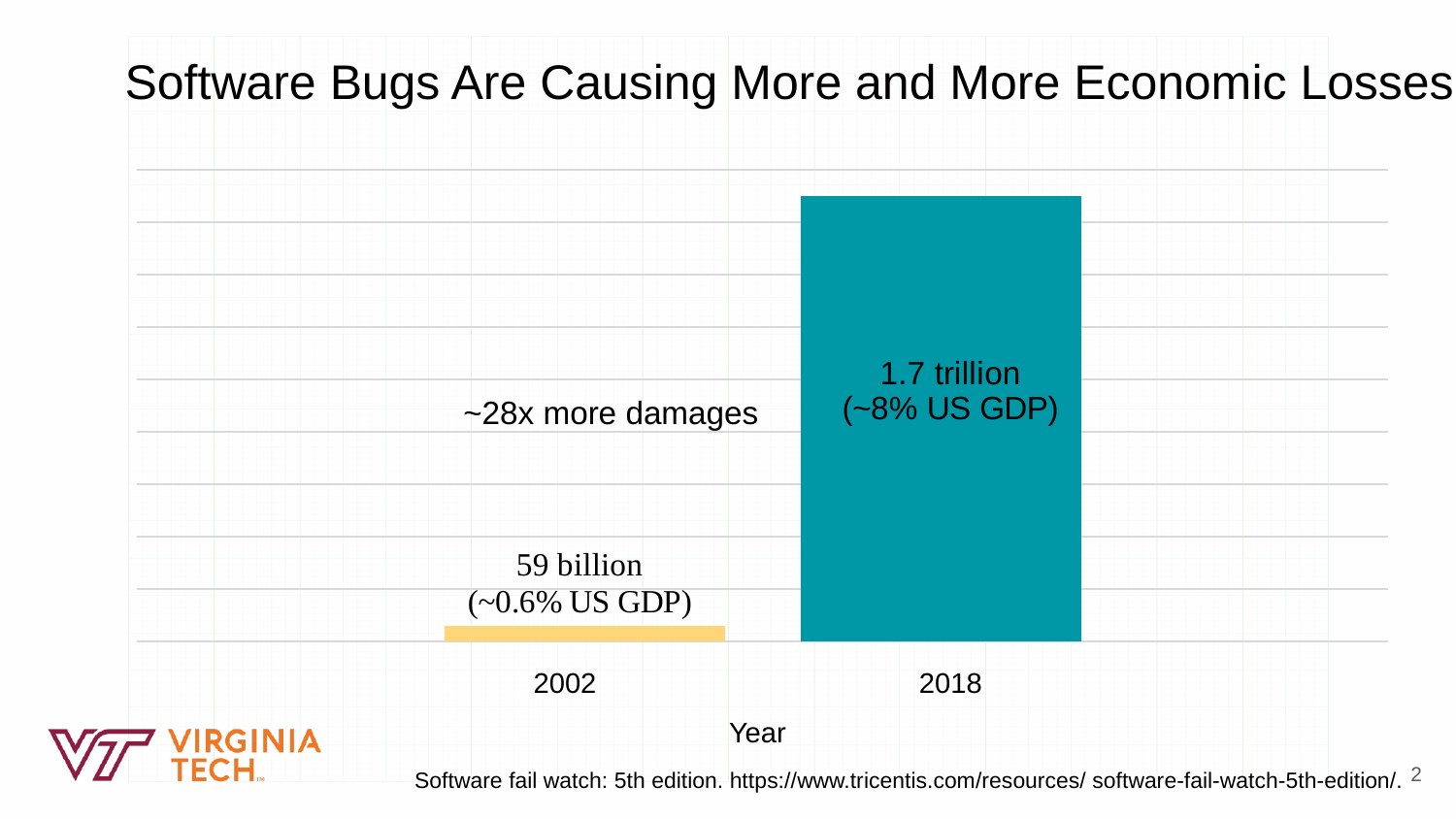
What share of US GDP does the slide give for the 2018 losses? ~8% US GDP Which is larger, the value for 2002 or the value for 2018? 2018 Which year has the highest bar? 2018 What is the label of the x axis? Year What is the title of the chart? Software Bugs Are Causing More and More Economic Losses What is the value of the bar for 2018? 1.7 trillion Do the values rise or fall from 2002 to 2018? rise Which year has the lowest bar? 2002 How many bars are plotted in the chart? 2 What is the value of the bar for 2002? 59 billion What share of US GDP does the slide give for the 2002 losses? ~0.6% US GDP What kind of chart is shown on the slide? bar chart